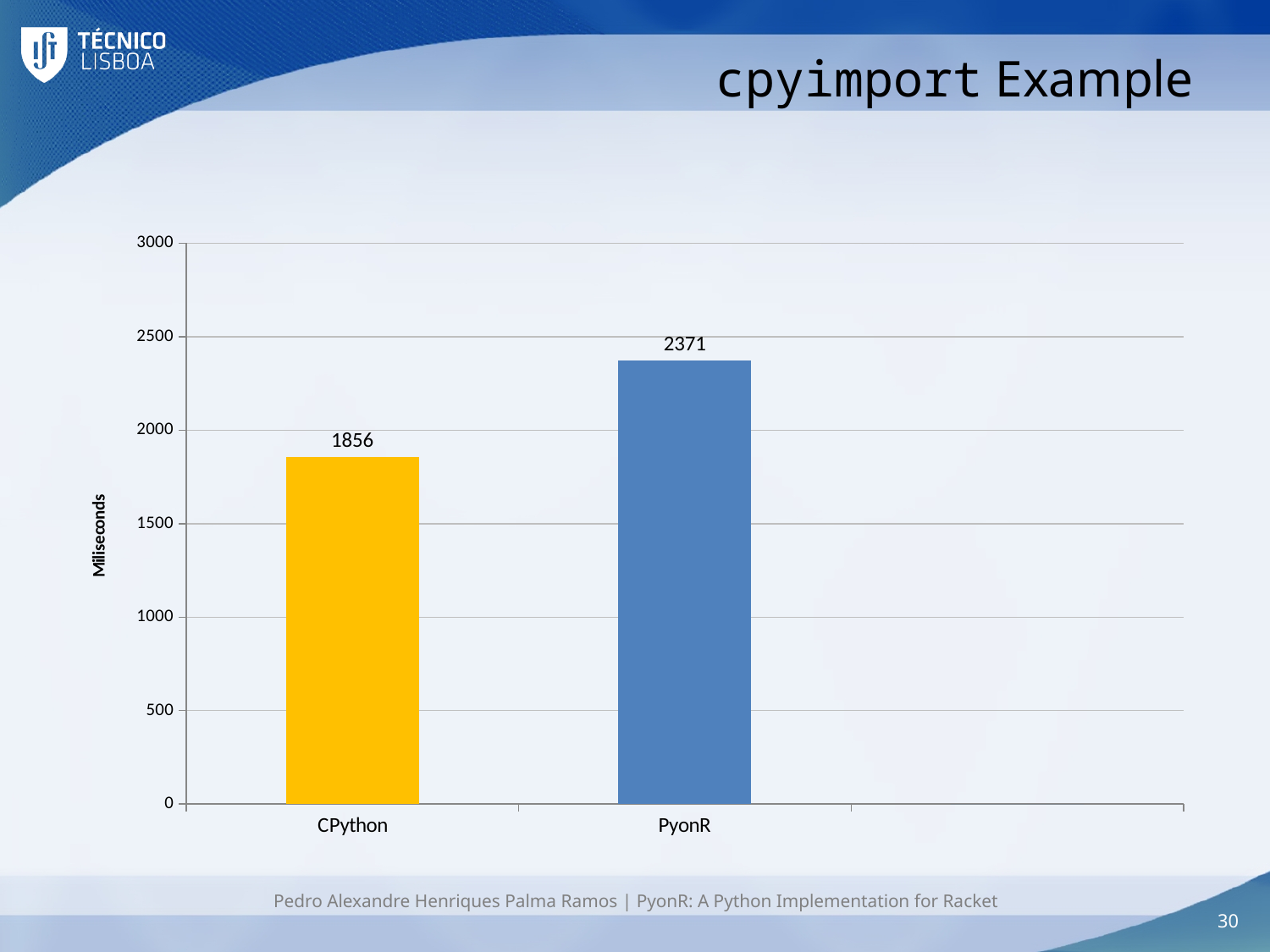
How many categories are shown on the x axis? 2 Which is larger, the value for CPython or the value for PyonR? PyonR Is the value for PyonR greater or less than 2000? greater What is the value for PyonR? 2371 What is the difference between the values for PyonR and CPython? 515 Which category has the highest value? PyonR What is the value for CPython? 1856 What colour is the bar for CPython? yellow Is the value for CPython greater or less than 2000? less What kind of chart is shown on the slide? bar chart Which category has the lowest value? CPython What is the label of the y axis? Miliseconds